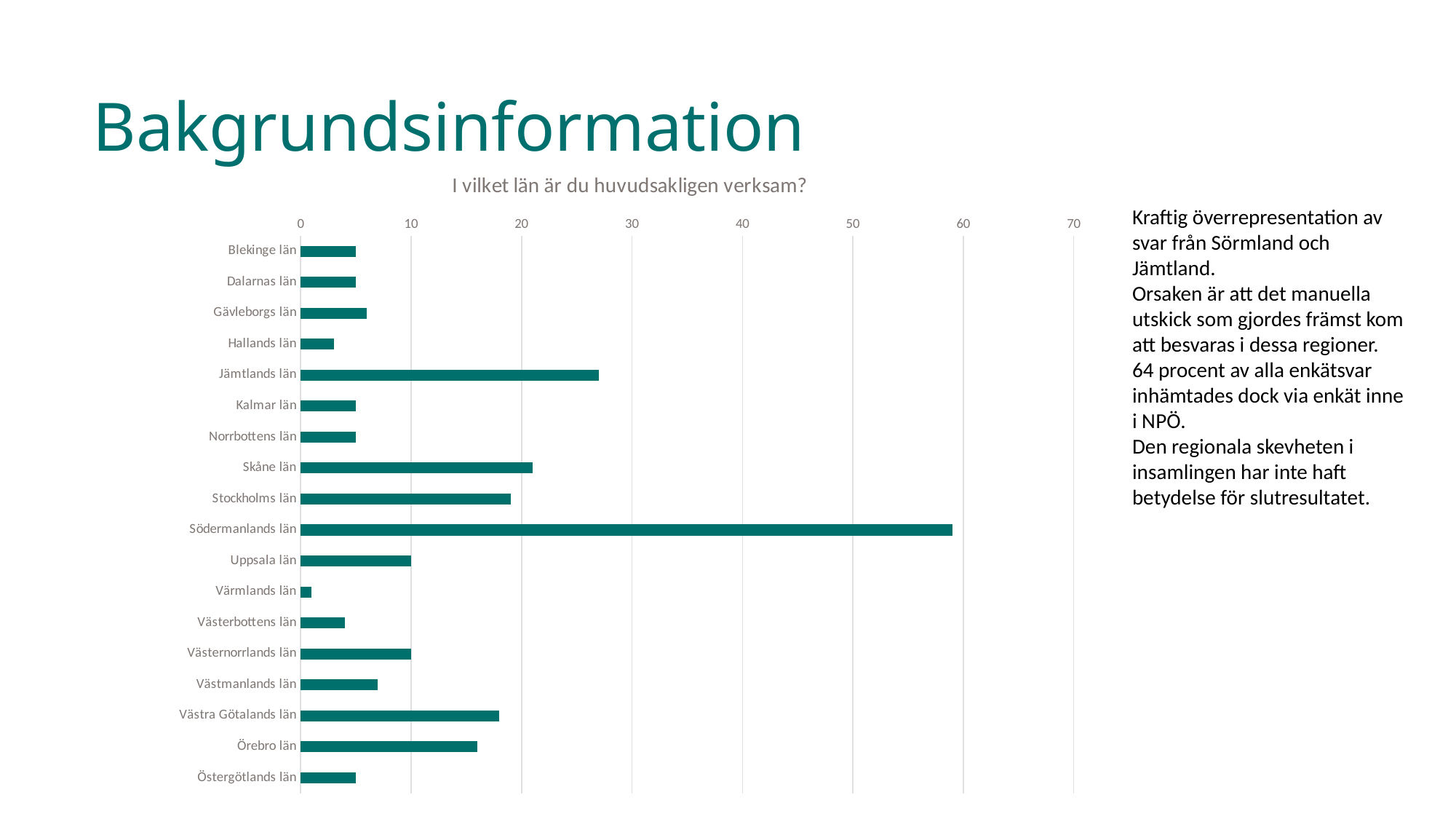
Which has a larger value, Jämtlands län or Skåne län? Jämtlands län Which has a larger value, Örebro län or Uppsala län? Örebro län What kind of chart is shown on the slide? bar chart Which län has the lowest value in the chart? Värmlands län How many län (categories) are shown in the chart? 18 Is the value for Västra Götalands län greater or less than 20? less Is the value for Södermanlands län greater or less than 50? greater Which län has the highest value in the chart? Södermanlands län What is the title of the chart? I vilket län är du huvudsakligen verksam? Is the value for Hallands län greater or less than 10? less